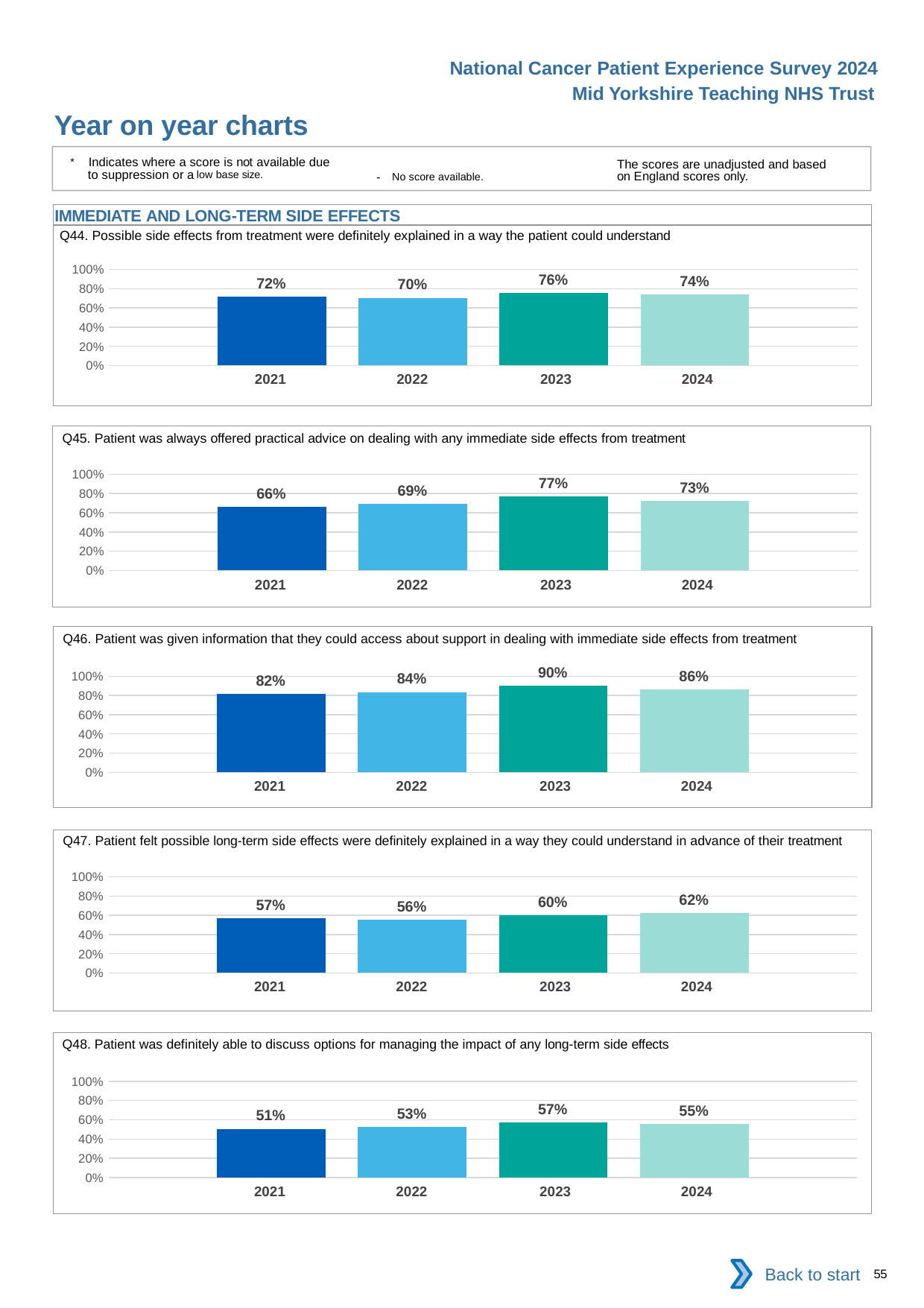
In the Q46 chart, what is the difference between the 2023 value and the 2021 value? 8% In the Q47 chart, what is the difference between the 2024 value and the 2022 value? 6% In the Q48 chart, what is the value for 2021? 51% In the Q47 chart, do the values rise or fall from 2022 to 2024? rise How many years are shown in the Q44 chart? 4 In the Q45 chart, which year has the lowest value? 2021 In the Q48 chart, which is larger, the value for 2022 or the value for 2024? 2024 What kind of chart is the Q46 chart? bar chart In the Q46 chart, which year has the highest value? 2023 In the Q44 chart, what is the value for 2023? 76% In the Q45 chart, is the value for 2023 greater or less than 60%? greater How many charts are shown on the slide? 5